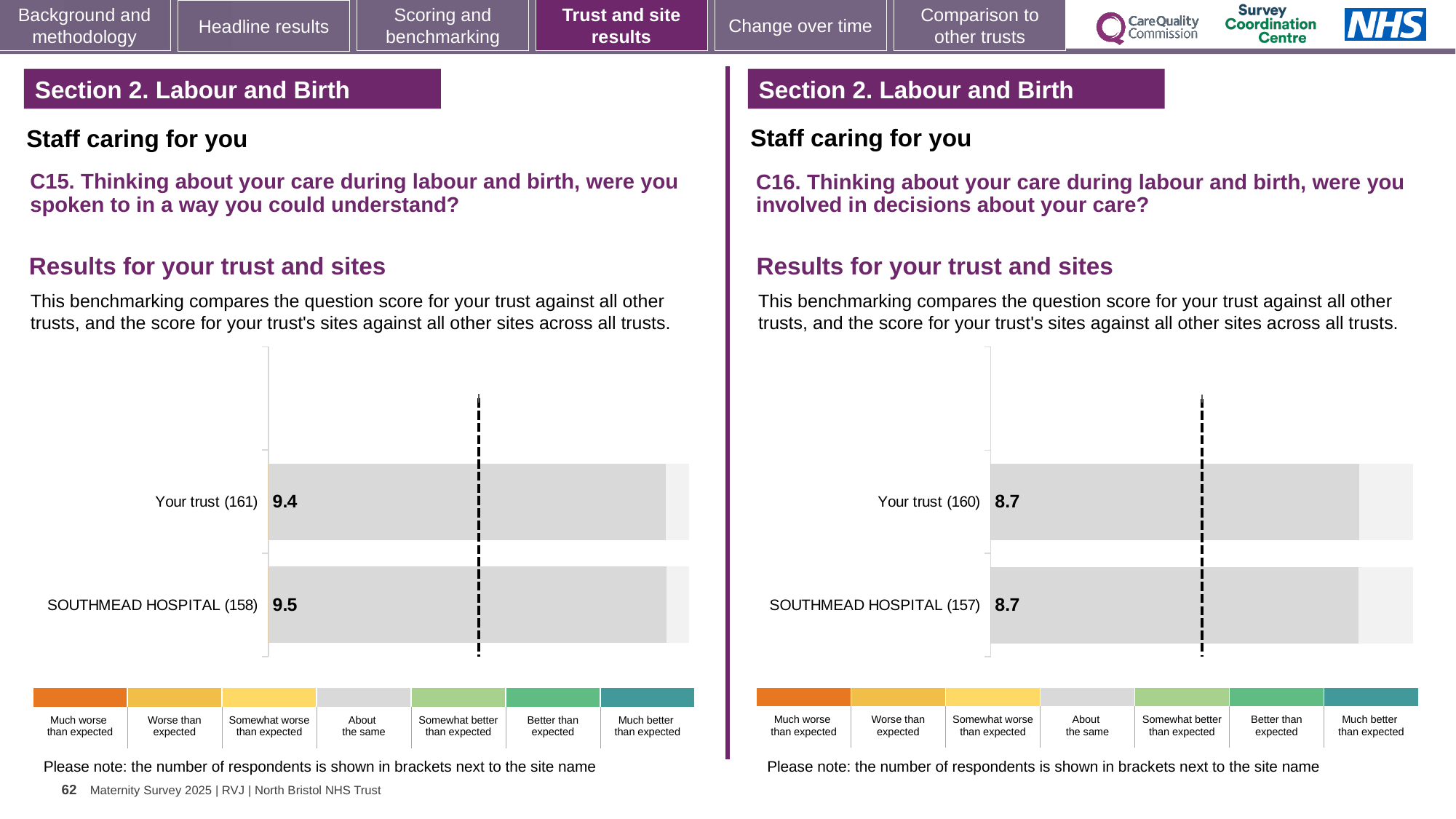
How many bars are plotted in the left chart (C15)? 2 In the right chart (C16), what is the score for SOUTHMEAD HOSPITAL? 8.7 In the left chart (C15), what is the score for Your trust? 9.4 What type of chart is used for the C15 results on the left? Bar chart How many bars are plotted in the right chart (C16)? 2 In the right chart (C16), how many respondents are shown in brackets for Your trust? 160 In the right chart (C16), what is the difference between the Your trust score and the SOUTHMEAD HOSPITAL score? 0 In the left chart (C15), what is the difference between the SOUTHMEAD HOSPITAL score and the Your trust score? 0.1 In the left chart (C15), how many respondents are shown in brackets for SOUTHMEAD HOSPITAL? 158 Is the Your trust score in the left chart (C15) higher or lower than the Your trust score in the right chart (C16)? Higher In the left chart (C15), what is the score for SOUTHMEAD HOSPITAL? 9.5 In the right chart (C16), what is the score for Your trust? 8.7